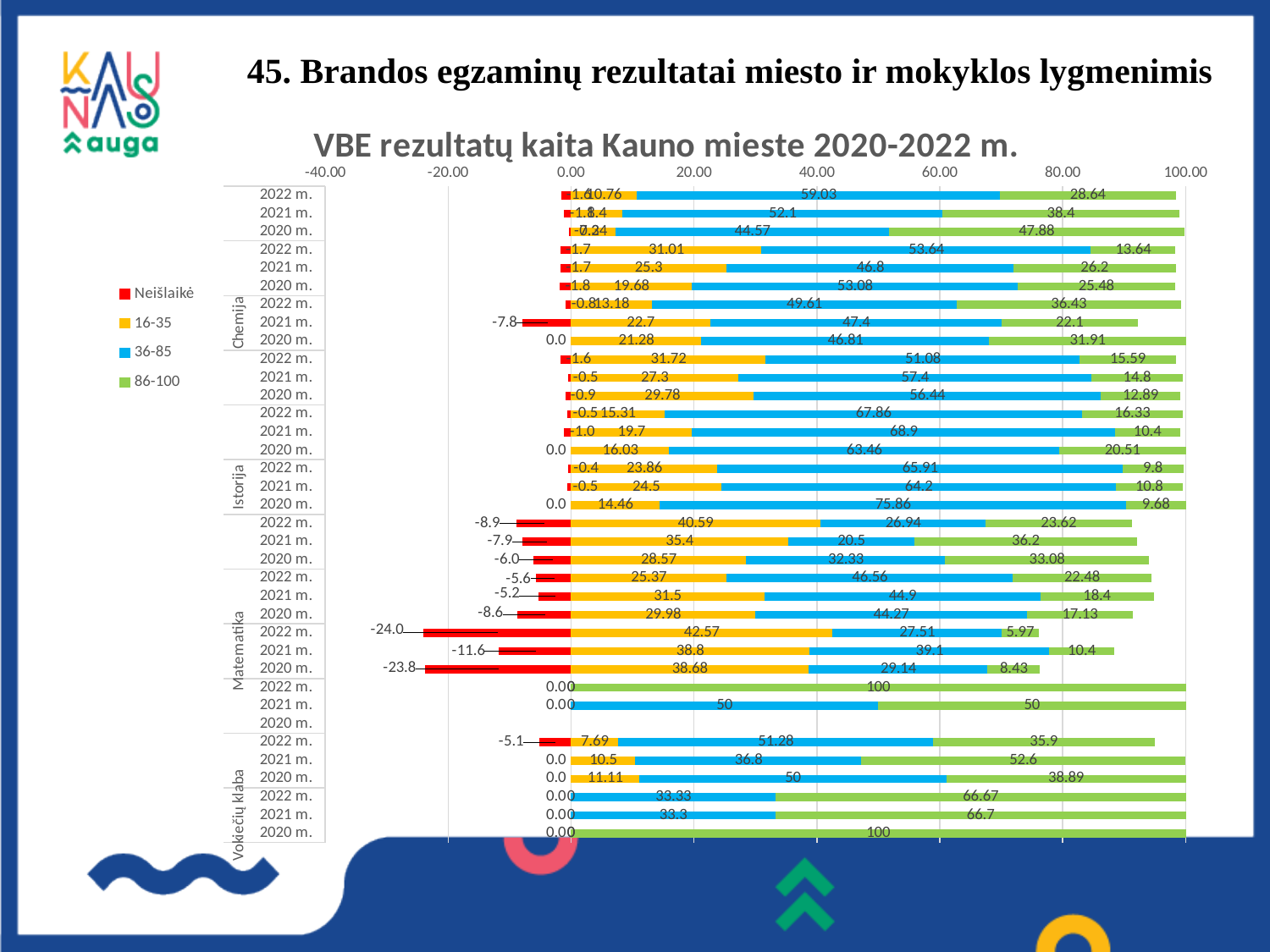
What is the title of the chart? VBE rezultatų kaita Kauno mieste 2020-2022 m. What is the difference between the 36-85 value and the 86-100 value for Istorija in 2021 m.? 53.4 What is the 16-35 value for Chemija in 2021 m.? 22.7 How many series does the legend list? 4 What is the 86-100 value for Vokiečių kalba in 2022 m.? 66.67 What is the 36-85 value for Istorija in 2020 m.? 75.86 Among the Matematika years, which year has the highest 16-35 value? 2022 m. Which is larger, the 36-85 value for Istorija in 2022 m. or the 36-85 value for Matematika in 2022 m.? Istorija 2022 m. What is the Neišlaikė value for Matematika in 2022 m.? -24.0 What is the 86-100 value for Matematika in 2021 m.? 10.4 What kind of chart is shown on the slide? bar chart What is the 36-85 value for Vokiečių kalba in 2020 m.? 0